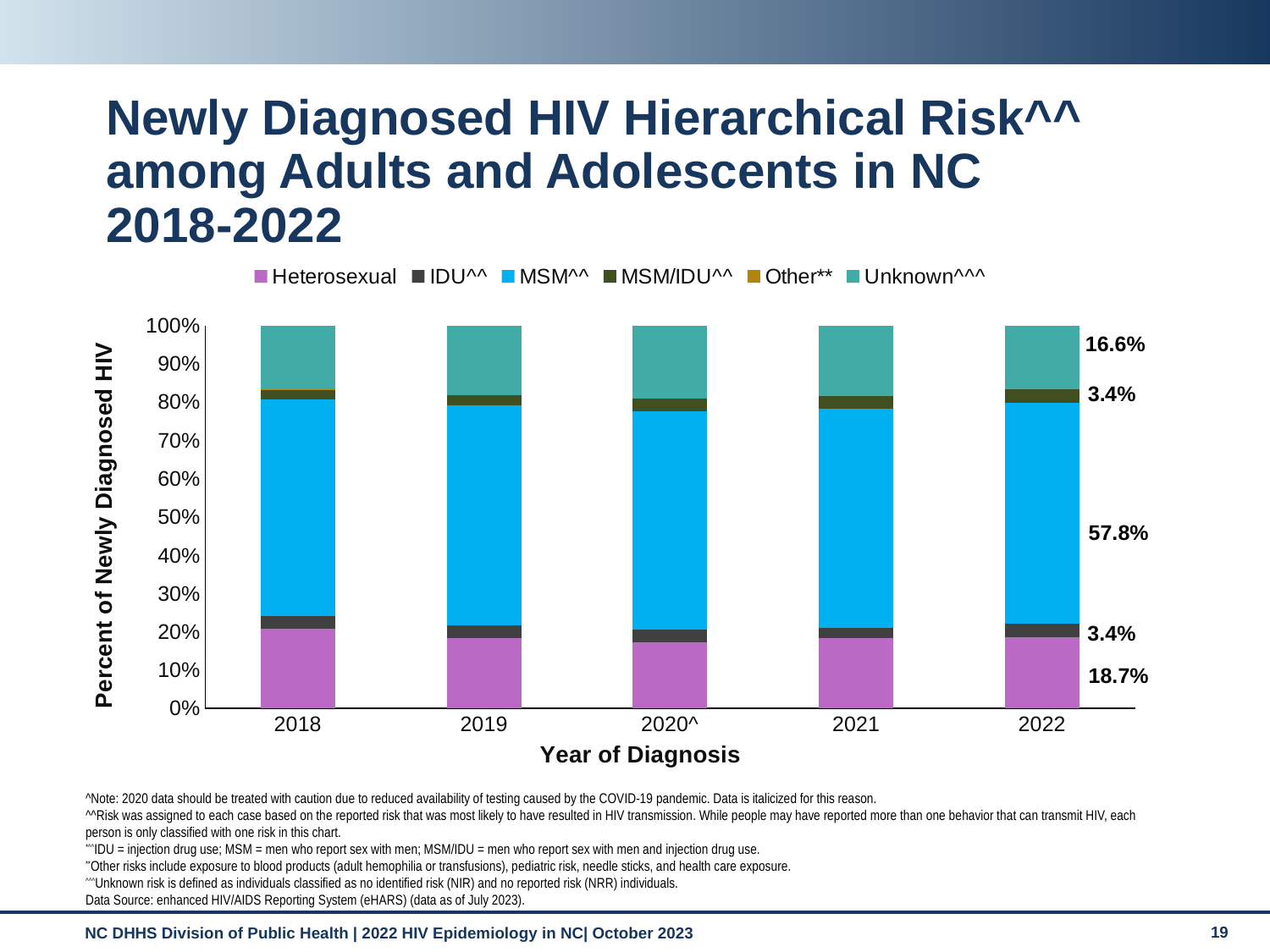
What percent of newly diagnosed HIV in 2022 is attributed to Heterosexual risk? 18.7% What percent of newly diagnosed HIV in 2022 has Unknown^^^ risk? 16.6% In 2022, how many percentage points larger is the MSM^^ share than the Heterosexual share? 39.1% What percent of newly diagnosed HIV in 2022 is attributed to MSM^^? 57.8% What kind of chart is shown on the slide? bar chart How many years of diagnosis are shown on the x axis? 5 Which risk category has the largest share of newly diagnosed HIV in 2022? MSM^^ In 2022, which is larger: the Heterosexual share or the Unknown^^^ share? Heterosexual How many series does the legend list? 6 What percent of newly diagnosed HIV in 2022 is attributed to IDU^^? 3.4% Is the Heterosexual share of newly diagnosed HIV in 2018 greater or less than 30%? less What is the title of the x axis? Year of Diagnosis